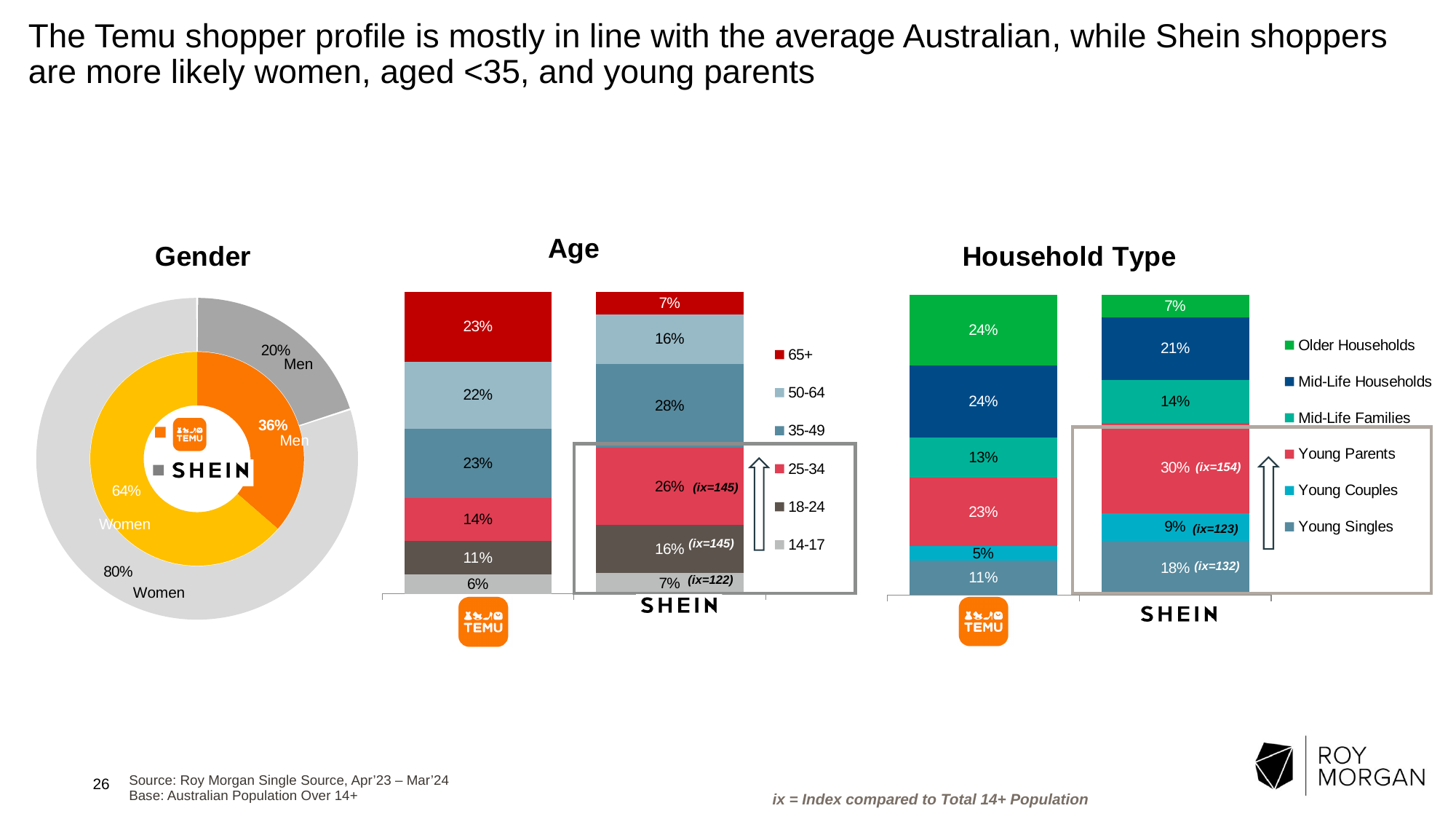
In the Age chart, how many age groups does the legend list? 6 What kind of chart is the Age chart? Stacked bar chart In the Household Type chart, which household type has the smallest share of Shein shoppers? Older Households In the Gender chart, what percentage of Shein shoppers are men? 20% In the Age chart, which age group has the largest share of Shein shoppers? 35-49 In the Household Type chart, which has the larger share of Young Singles, Temu or Shein? Shein In the Age chart, how many percentage points higher is the 25-34 share for Shein than for Temu? 12 percentage points In the Age chart, what percentage of Temu shoppers are aged 14-17? 6% In the Household Type chart, what percentage of Temu shoppers are Young Couples? 5% In the Age chart, what percentage of Shein shoppers are aged 35-49? 28% In the Household Type chart, what percentage of Shein shoppers are Young Parents? 30% In the Gender chart, what percentage of Temu shoppers are women? 64%